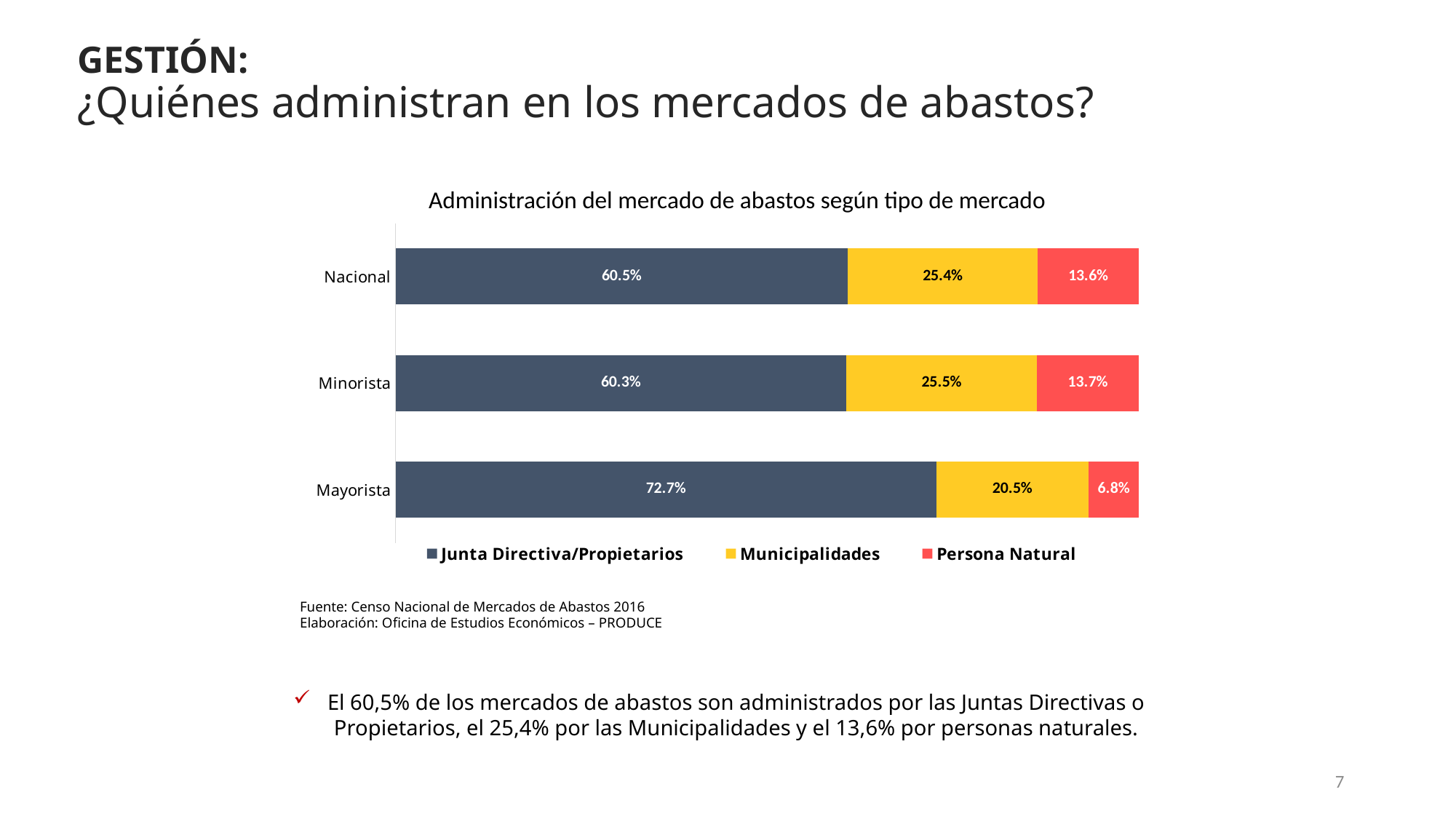
What is the difference between the Junta Directiva/Propietarios values for Mayorista and Nacional? 12.2% What is the value for Junta Directiva/Propietarios in the Nacional bar? 60.5% Which market type has the highest value for Junta Directiva/Propietarios? Mayorista What kind of chart is shown on the slide? Stacked bar chart Which is larger: the Municipalidades value for Nacional or for Mayorista? Nacional Which market type has the lowest value for Persona Natural? Mayorista How many market types are shown on the chart? 3 What is the title of the chart? Administración del mercado de abastos según tipo de mercado What is the value for Persona Natural in the Mayorista bar? 6.8% What is the value for Municipalidades in the Minorista bar? 25.5% How many series does the legend list? 3 What is the value for Municipalidades in the Mayorista bar? 20.5%